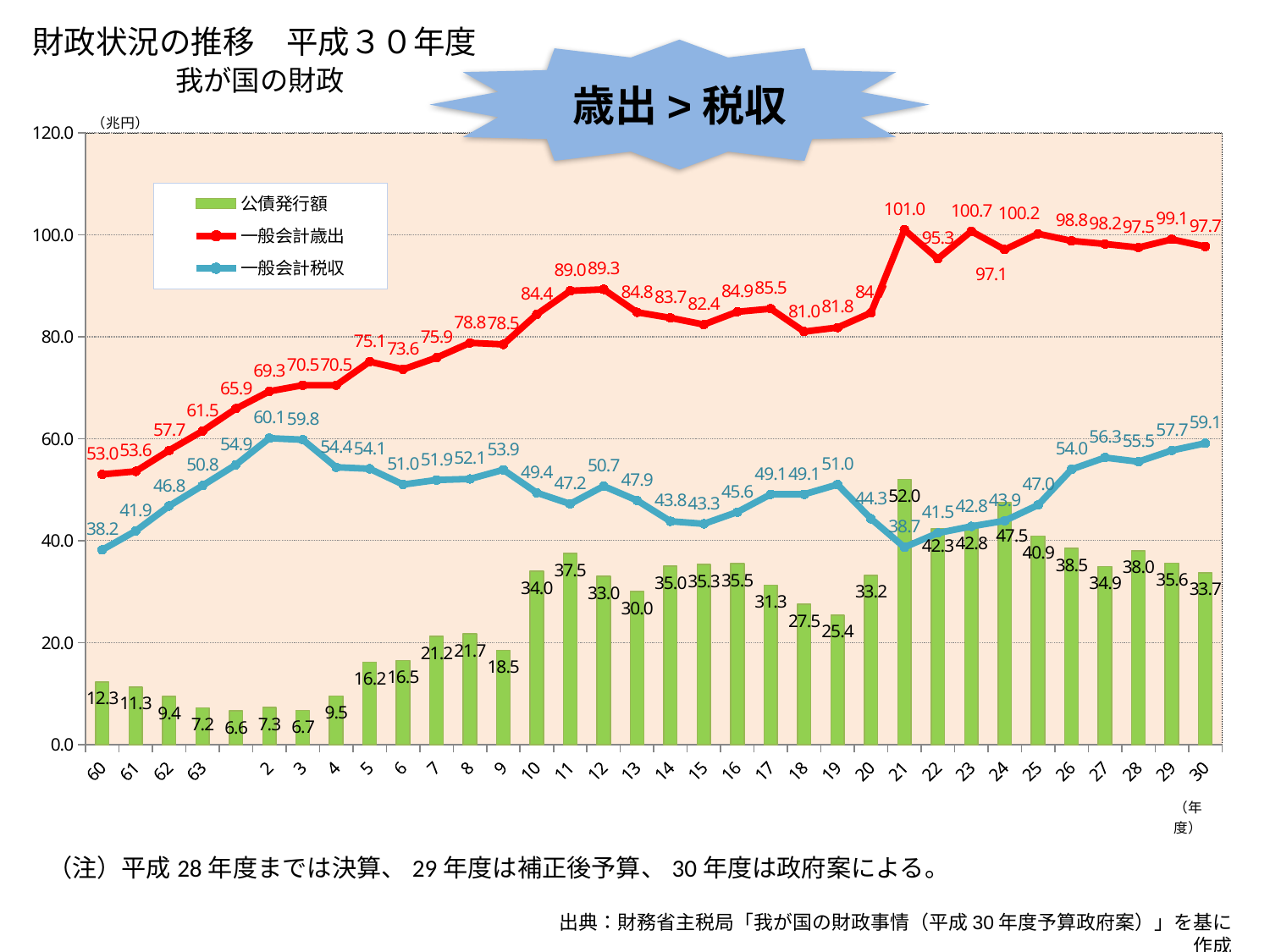
What is the value of 一般会計税収 for year 21? 38.7 In which year is 一般会計歳出 highest? 21 What kind of chart is this? Combined bar and line chart What is the value of 一般会計歳出 for year 30? 97.7 How many series does the legend list? 3 Does 一般会計税収 rise or fall from year 21 to year 30? rise Is the value of 一般会計歳出 for year 20 greater or less than 80.0? greater In which year is 公債発行額 highest? 21 What is the value of 公債発行額 for year 10? 34.0 What is the difference between 一般会計歳出 and 一般会計税収 in year 30? 38.6 Which year has the larger 一般会計税収, year 2 or year 30? 2 In which year is 一般会計税収 lowest? 60